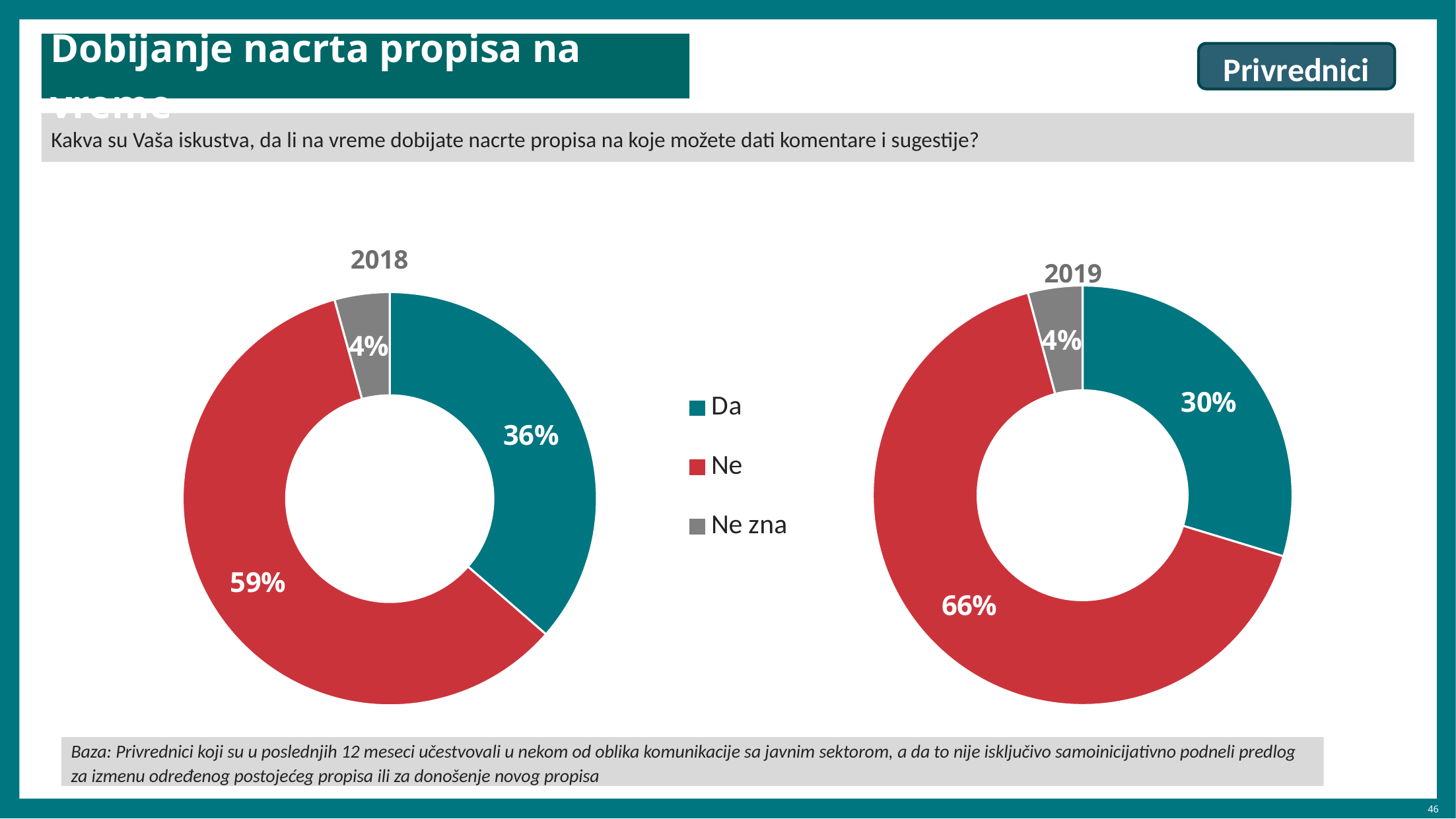
What is the difference between the "Ne" share in 2019 and the "Ne" share in 2018? 7 percentage points In the 2019 chart, what share of respondents answered "Ne zna"? 4% In the 2019 chart, what share of respondents answered "Ne"? 66% In the 2019 chart, what share of respondents answered "Da"? 30% In the 2019 chart, which answer has the smallest share? Ne zna Which colour represents "Ne" in the legend? Red Is the "Da" share larger in the 2018 chart or the 2019 chart? 2018 How many categories does each donut chart show? 3 In the 2018 chart, which answer has the largest share? Ne In the 2018 chart, what share of respondents answered "Da"? 36% In the 2018 chart, what share of respondents answered "Ne"? 59% What type of chart is used for the 2018 and 2019 data? Donut (pie) chart